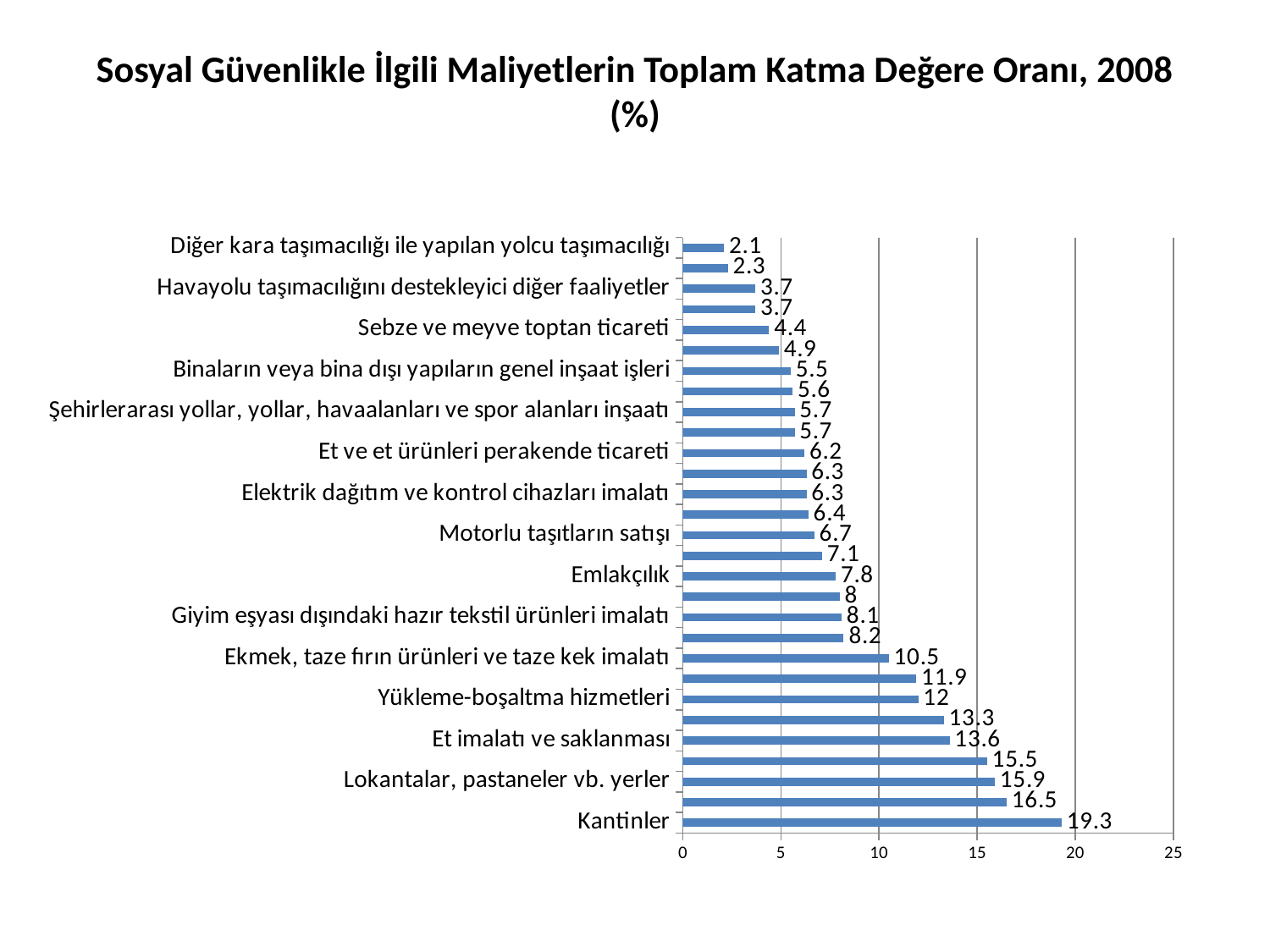
What is the difference between the values for Kantinler and Lokantalar, pastaneler vb. yerler? 3.4 What type of chart is shown on the slide? Bar chart Which category has the lowest value? Diğer kara taşımacılığı ile yapılan yolcu taşımacılığı Is the value for Motorlu taşıtların satışı greater or less than 10? less How many bars are plotted in the chart? 29 Which category has the highest value? Kantinler What is the value for Emlakçılık? 7.8 What is the value for Kantinler? 19.3 Which is larger, the value for Et imalatı ve saklanması or the value for Ekmek, taze fırın ürünleri ve taze kek imalatı? Et imalatı ve saklanması What is the title of the chart? Sosyal Güvenlikle İlgili Maliyetlerin Toplam Katma Değere Oranı, 2008 (%) What is the value for Yükleme-boşaltma hizmetleri? 12 What is the value for Sebze ve meyve toptan ticareti? 4.4